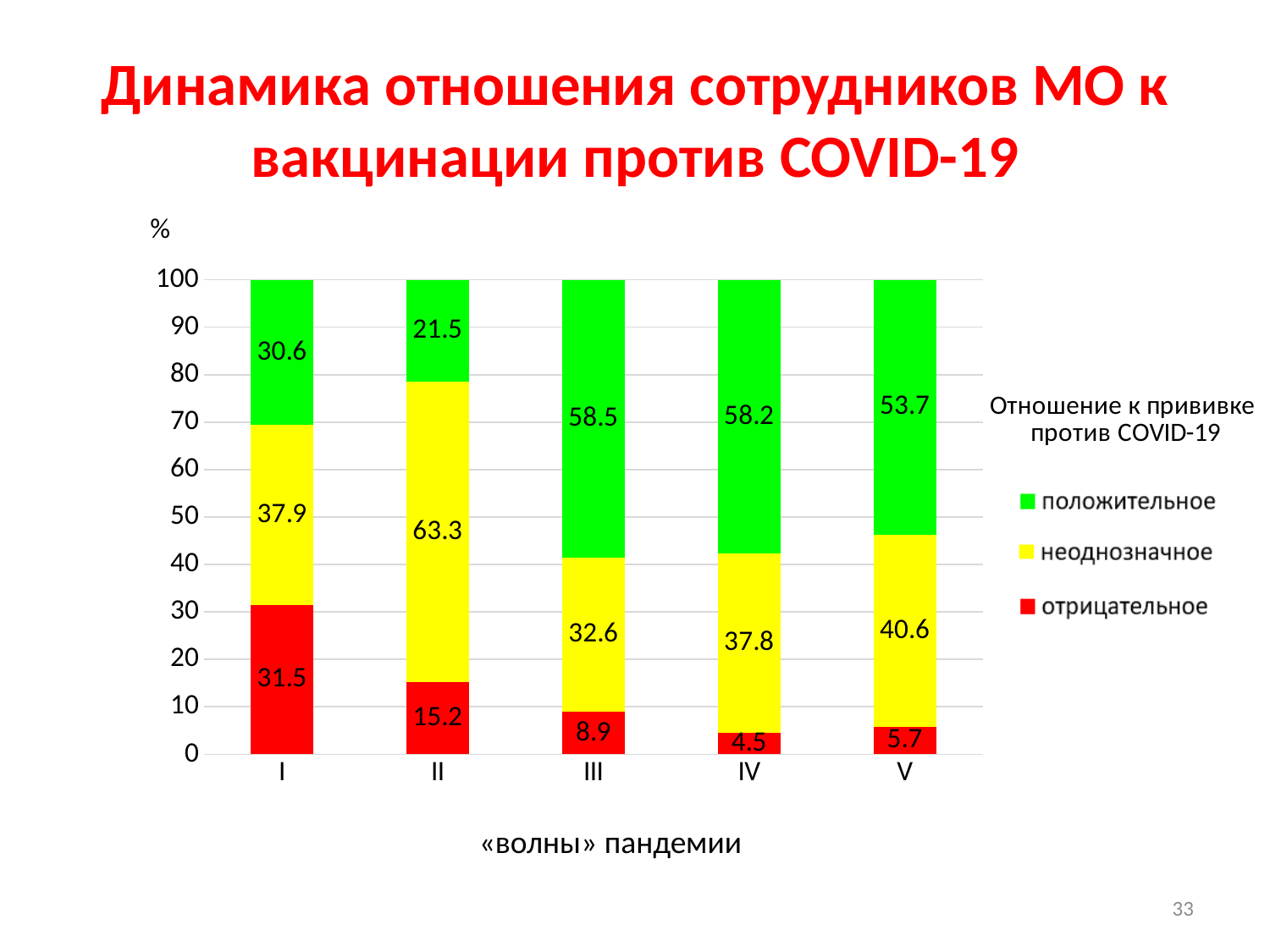
In which wave is the «положительное» value highest? III What is the difference between the «положительное» values in wave V and wave I? 23.1 How many waves (categories) are shown on the x axis? 5 How many series does the legend list? 3 What is the value for «положительное» in wave III? 58.5 Which is larger: the «неоднозначное» value in wave IV or in wave V? wave V Does the «отрицательное» value rise or fall from wave I to wave IV? fall What kind of chart is shown on the slide? stacked bar chart Which colour represents «неоднозначное» in the chart? yellow In which wave is the «отрицательное» value lowest? IV What is the value for «отрицательное» in wave I? 31.5 What is the value for «неоднозначное» in wave II? 63.3